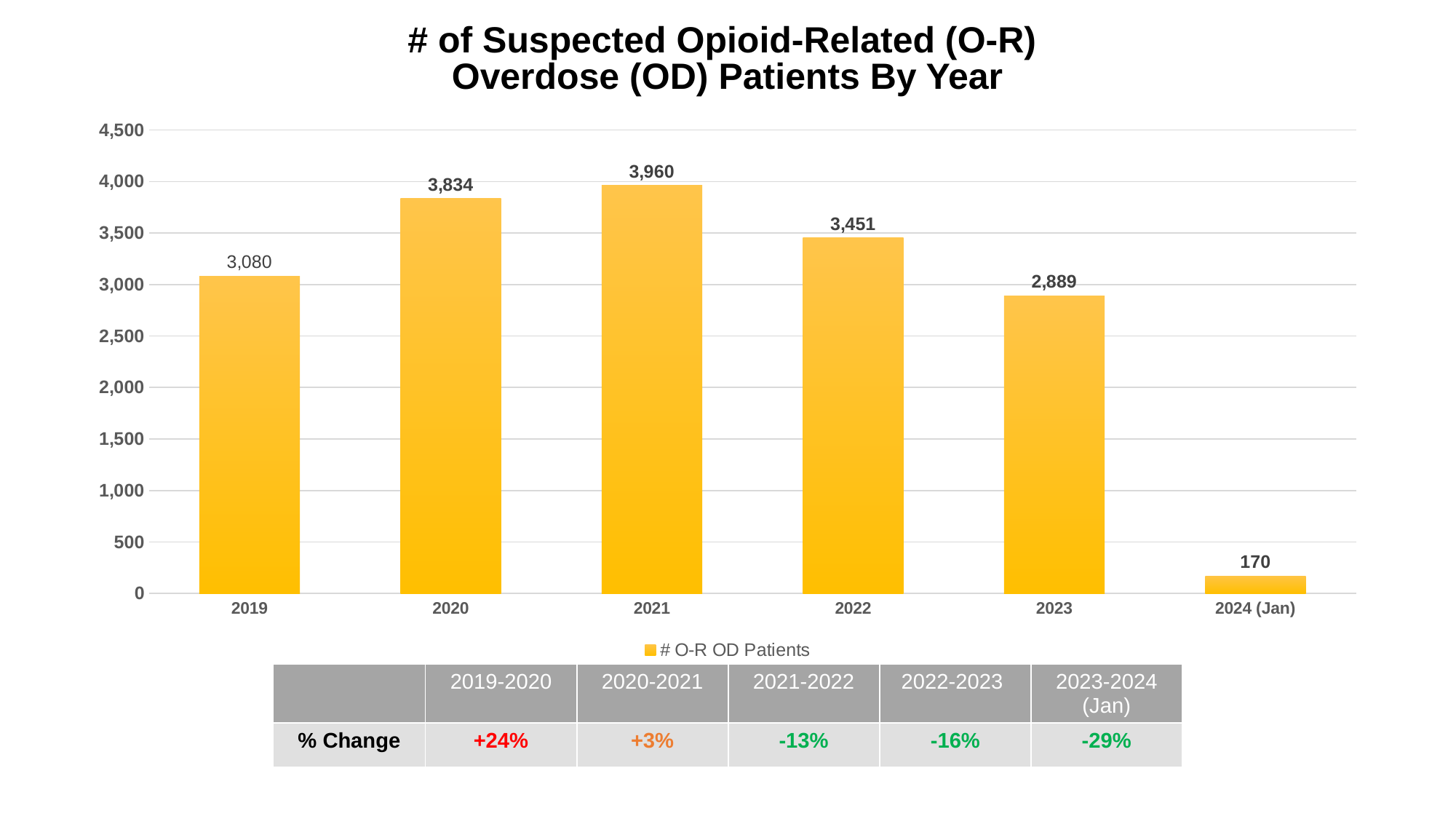
What is the number of O-R OD patients in 2023? 2,889 What is the number of O-R OD patients in 2019? 3,080 Which category has the lowest number of O-R OD patients? 2024 (Jan) What is the difference in O-R OD patients between 2022 and 2023? 562 What is the number of O-R OD patients in 2021? 3,960 Which year has more O-R OD patients, 2020 or 2022? 2020 What is the number of O-R OD patients for 2024 (Jan)? 170 How many categories are shown on the x axis? 6 Which year has the highest number of O-R OD patients? 2021 What type of chart is shown on the slide? bar chart Is the value for 2022 greater or less than 3,500? less What is the difference in O-R OD patients between 2020 and 2019? 754